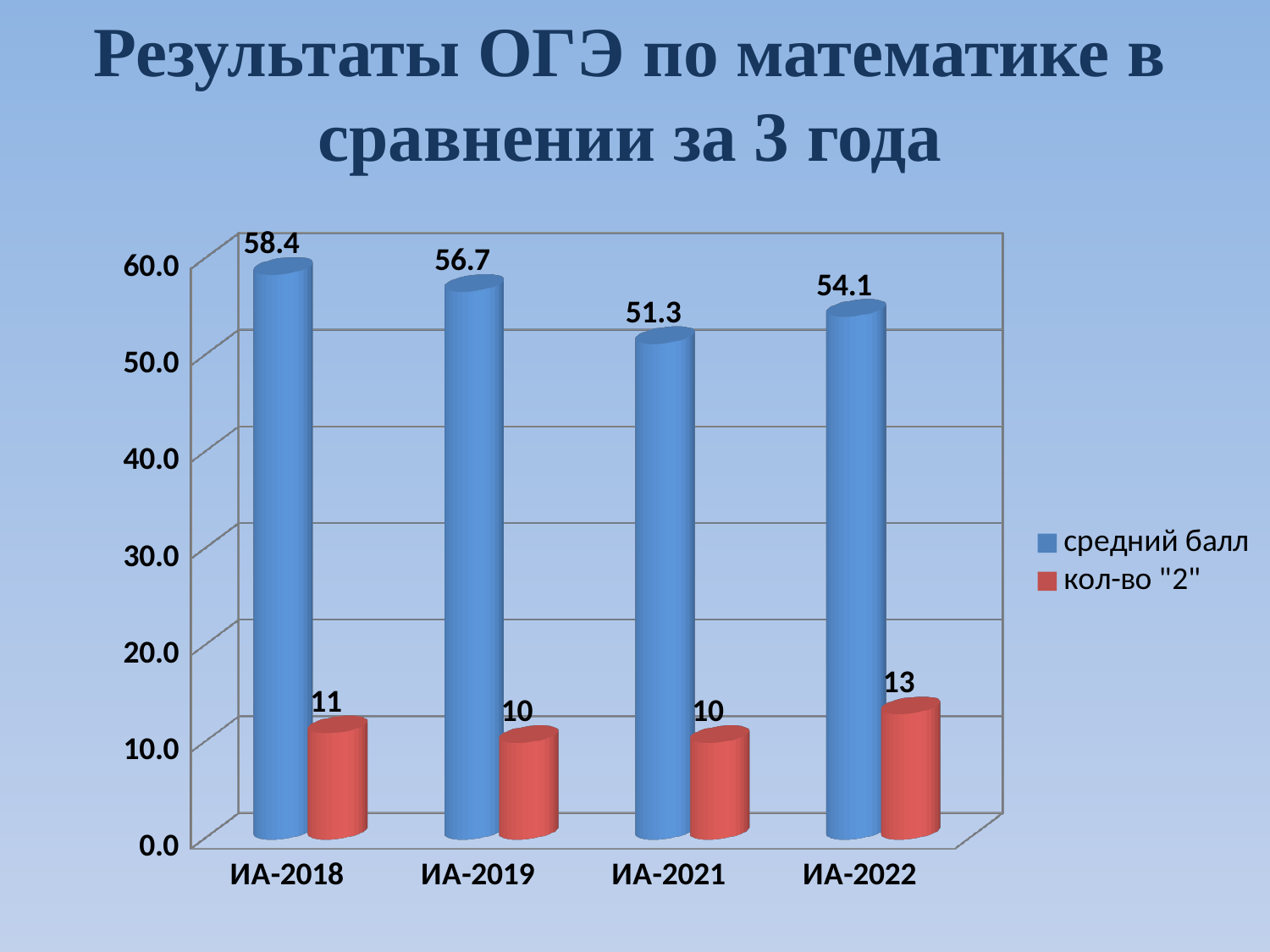
Which category has the highest средний балл? ИА-2018 Which category has the lowest средний балл? ИА-2021 What is the средний балл for ИА-2021? 51.3 How many series does the legend list? 2 What is the difference between the средний балл for ИА-2018 and ИА-2022? 4.3 What is the средний балл for ИА-2018? 58.4 Which is larger, the средний балл for ИА-2019 or for ИА-2022? ИА-2019 What kind of chart is shown on the slide? Bar chart How many categories are shown on the x axis? 4 What is the difference in кол-во "2" between ИА-2022 and ИА-2019? 3 Which category has the highest кол-во "2"? ИА-2022 What is the кол-во "2" value for ИА-2022? 13